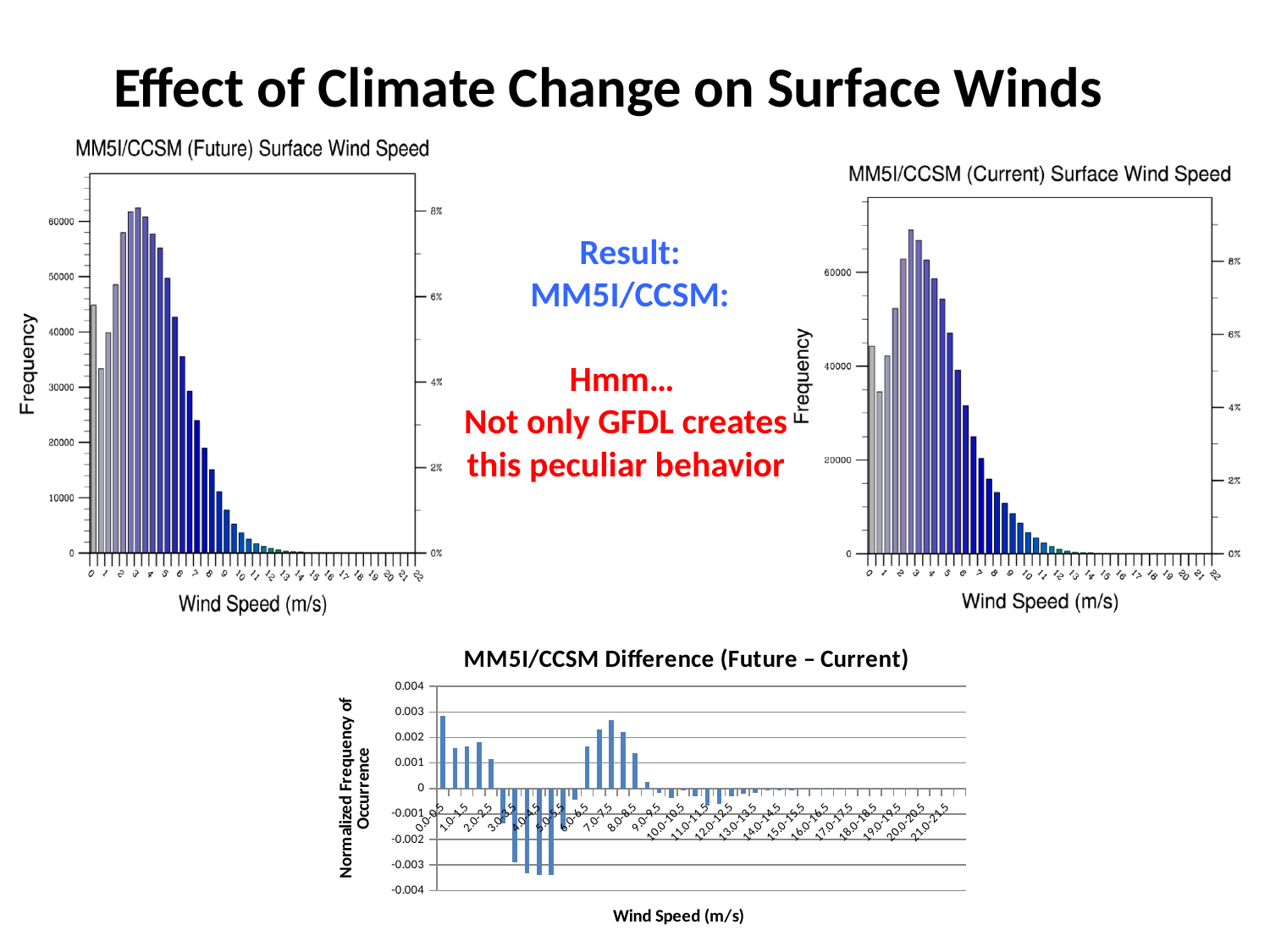
What kind of chart is the 'MM5I/CCSM (Future) Surface Wind Speed' chart? bar chart What is the y-axis label of the 'MM5I/CCSM Difference (Future – Current)' chart? Normalized Frequency of Occurrence What is the x-axis label of the 'MM5I/CCSM (Current) Surface Wind Speed' chart? Wind Speed (m/s) In the 'MM5I/CCSM Difference (Future – Current)' chart, is the value for 4.0-4.5 greater or less than -0.003? less In the 'MM5I/CCSM Difference (Future – Current)' chart, is the value for 7.0-7.5 greater or less than 0.002? greater In the 'MM5I/CCSM Difference (Future – Current)' chart, is the value for 1.0-1.5 greater or less than 0.001? greater In the 'MM5I/CCSM Difference (Future – Current)' chart, do the values rise or fall from 7.0-7.5 to 9.0-9.5? fall In the 'MM5I/CCSM (Future) Surface Wind Speed' chart, do the frequencies rise or fall as wind speed increases from 6 to 14 m/s? fall What kind of chart is the 'MM5I/CCSM Difference (Future – Current)' chart at the bottom of the slide? bar chart